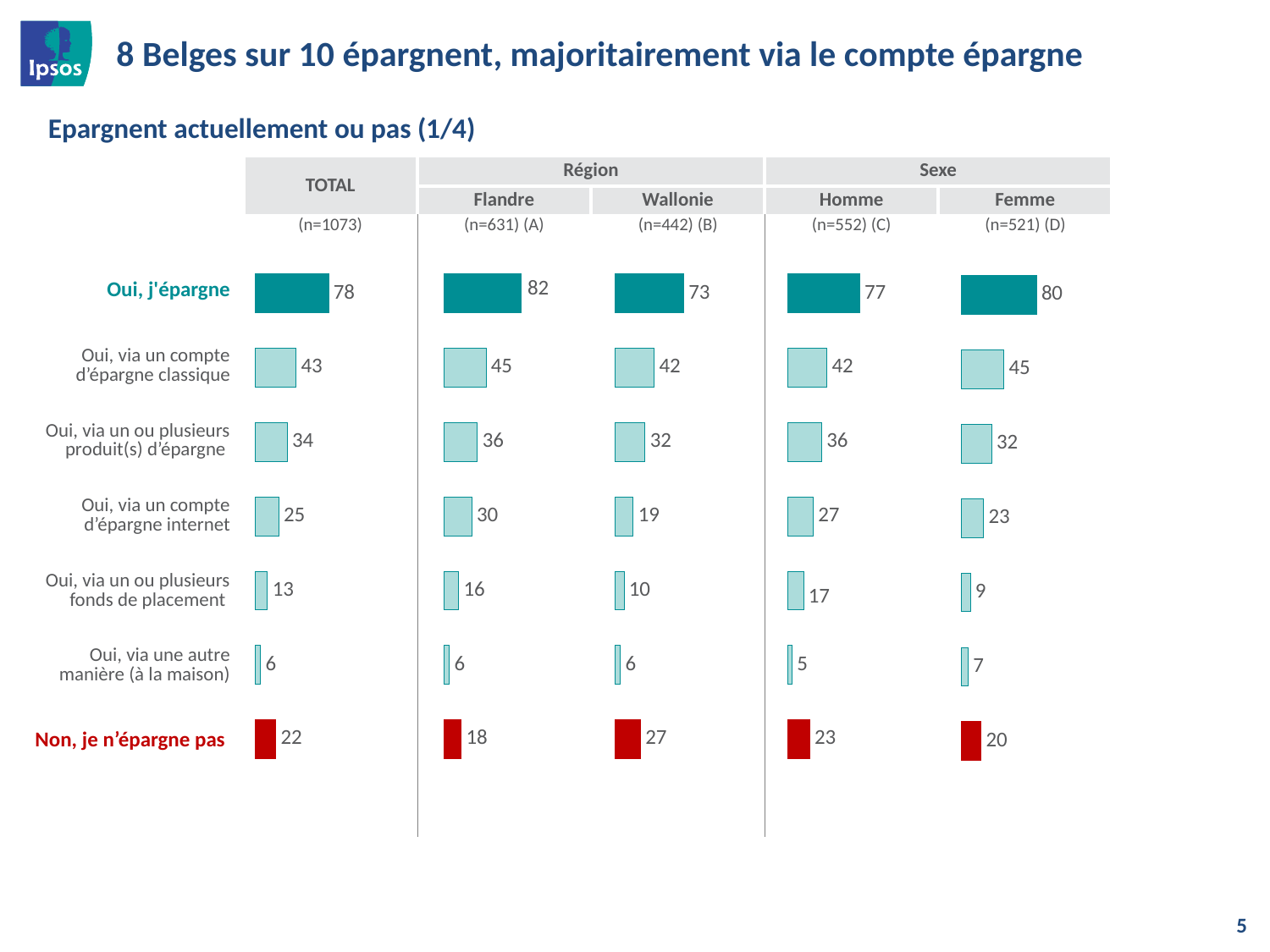
In the TOTAL column, what is the value for "Oui, j'épargne"? 78 Across the five columns, which column has the highest value for "Oui, j'épargne"? Flandre What is the sample size (n) shown for the Wallonie column? 442 In the Homme column, what is the value for "Oui, via un compte d'épargne internet"? 27 In the Wallonie column, what is the value for "Non, je n'épargne pas"? 27 In the TOTAL column, which category has the lowest value? Oui, via une autre manière (à la maison) How many categories are shown in each column of the chart? 7 What colour are the bars for "Non, je n'épargne pas"? Red What kind of chart is used on this slide? Bar chart In the Femme column, what is the value for "Oui, via un ou plusieurs fonds de placement"? 9 Which is larger: the Homme value or the Femme value for "Oui, via un ou plusieurs fonds de placement"? Homme What is the difference between the Flandre and Wallonie values for "Oui, via un compte d'épargne internet"? 11